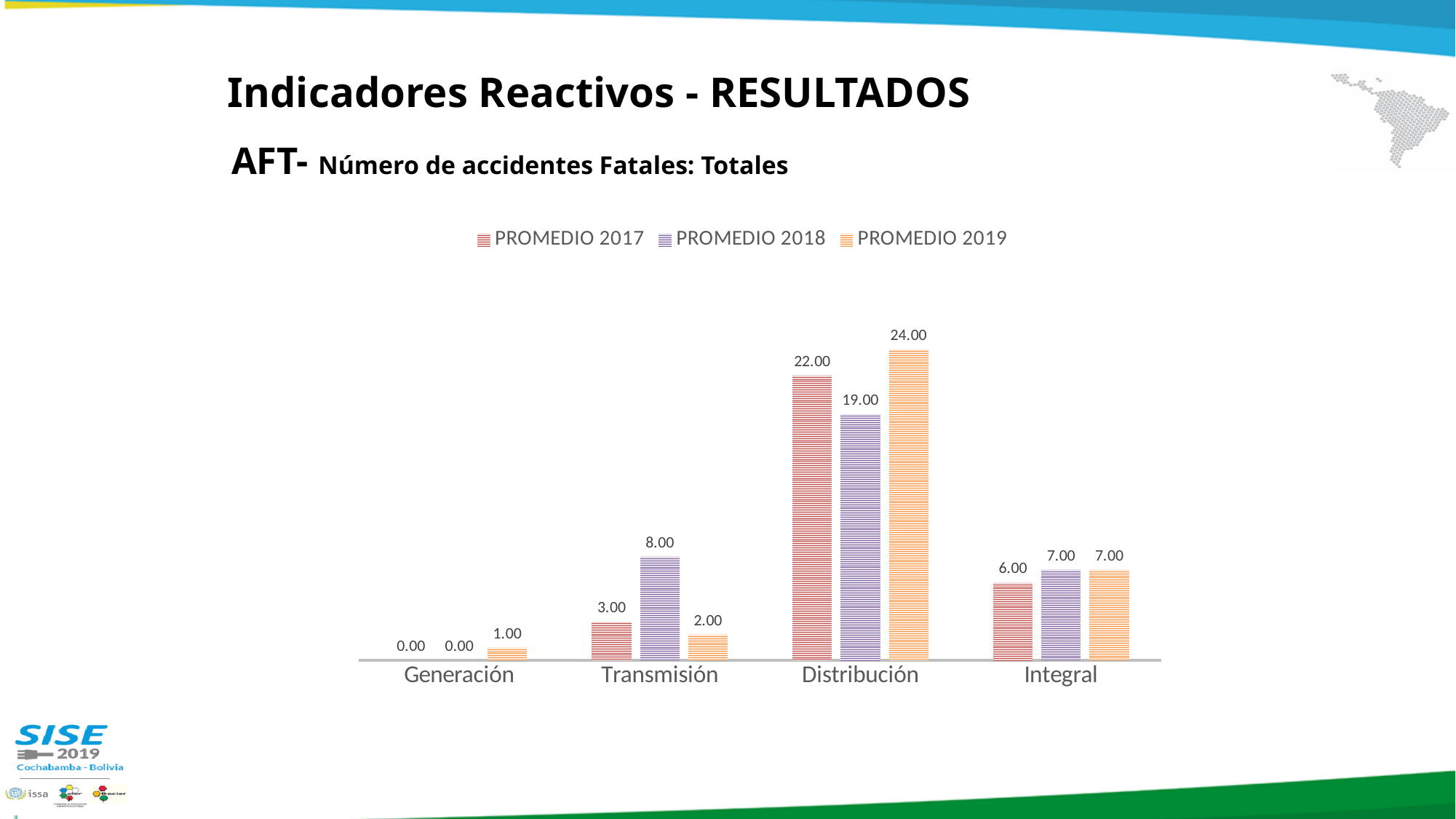
What is the PROMEDIO 2017 value for Integral? 6.00 What is the difference between the PROMEDIO 2017 and PROMEDIO 2018 values for Distribución? 3.00 How many categories are shown on the x axis? 4 What is the PROMEDIO 2019 value for Distribución? 24.00 What is the subtitle of the chart shown on the slide? AFT- Número de accidentes Fatales: Totales What is the total of the three series values for Generación? 1.00 How many series does the legend list? 3 What kind of chart is shown on the slide? Bar chart Which category has the highest PROMEDIO 2017 value? Distribución What is the PROMEDIO 2018 value for Transmisión? 8.00 Which is larger for Transmisión: PROMEDIO 2017 or PROMEDIO 2019? PROMEDIO 2017 Which category has the lowest PROMEDIO 2019 value? Generación